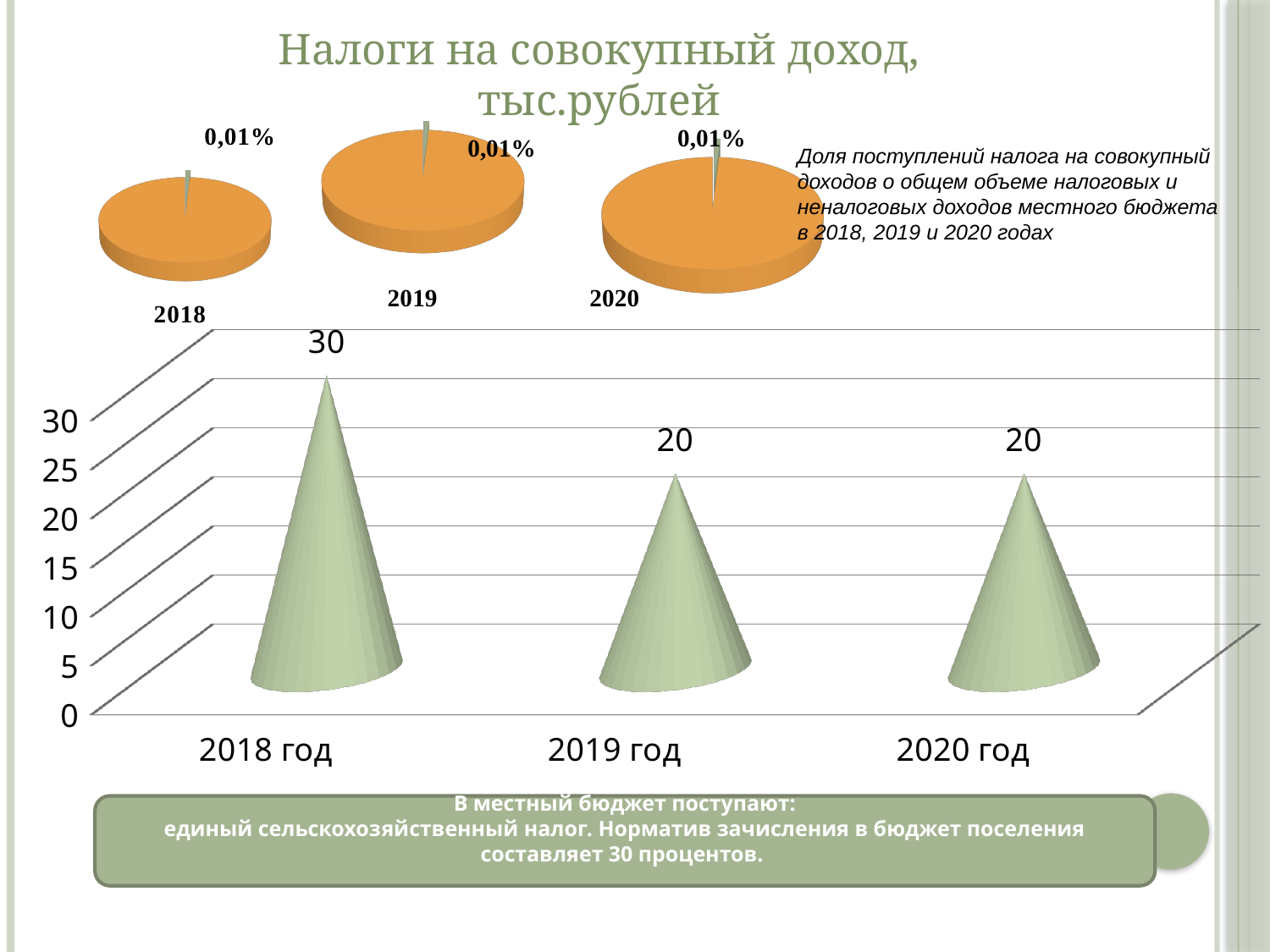
In the bar chart 'Налоги на совокупный доход, тыс.рублей', which is larger, the value for 2018 год or for 2020 год? 2018 год In the bar chart 'Налоги на совокупный доход, тыс.рублей', what is the value for 2018 год? 30 In the bar chart 'Налоги на совокупный доход, тыс.рублей', what is the difference between the values for 2018 год and 2019 год? 10 How many small pie charts are shown at the top of the slide? 3 In the bar chart 'Налоги на совокупный доход, тыс.рублей', what is the value for 2019 год? 20 In the bar chart 'Налоги на совокупный доход, тыс.рублей', is the value for 2019 год greater or less than 25? less In the bar chart 'Налоги на совокупный доход, тыс.рублей', do the values rise or fall from 2018 год to 2019 год? fall In the bar chart 'Налоги на совокупный доход, тыс.рублей', which year has the highest value? 2018 год What kind of chart is the large chart at the bottom of the slide showing values for 2018 год, 2019 год and 2020 год? bar chart In the bar chart 'Налоги на совокупный доход, тыс.рублей', what is the value for 2020 год? 20 How many categories (years) are shown in the bar chart 'Налоги на совокупный доход, тыс.рублей'? 3 In the small pie chart labelled 2018 at the top of the slide, what percentage is shown as the data label? 0,01%